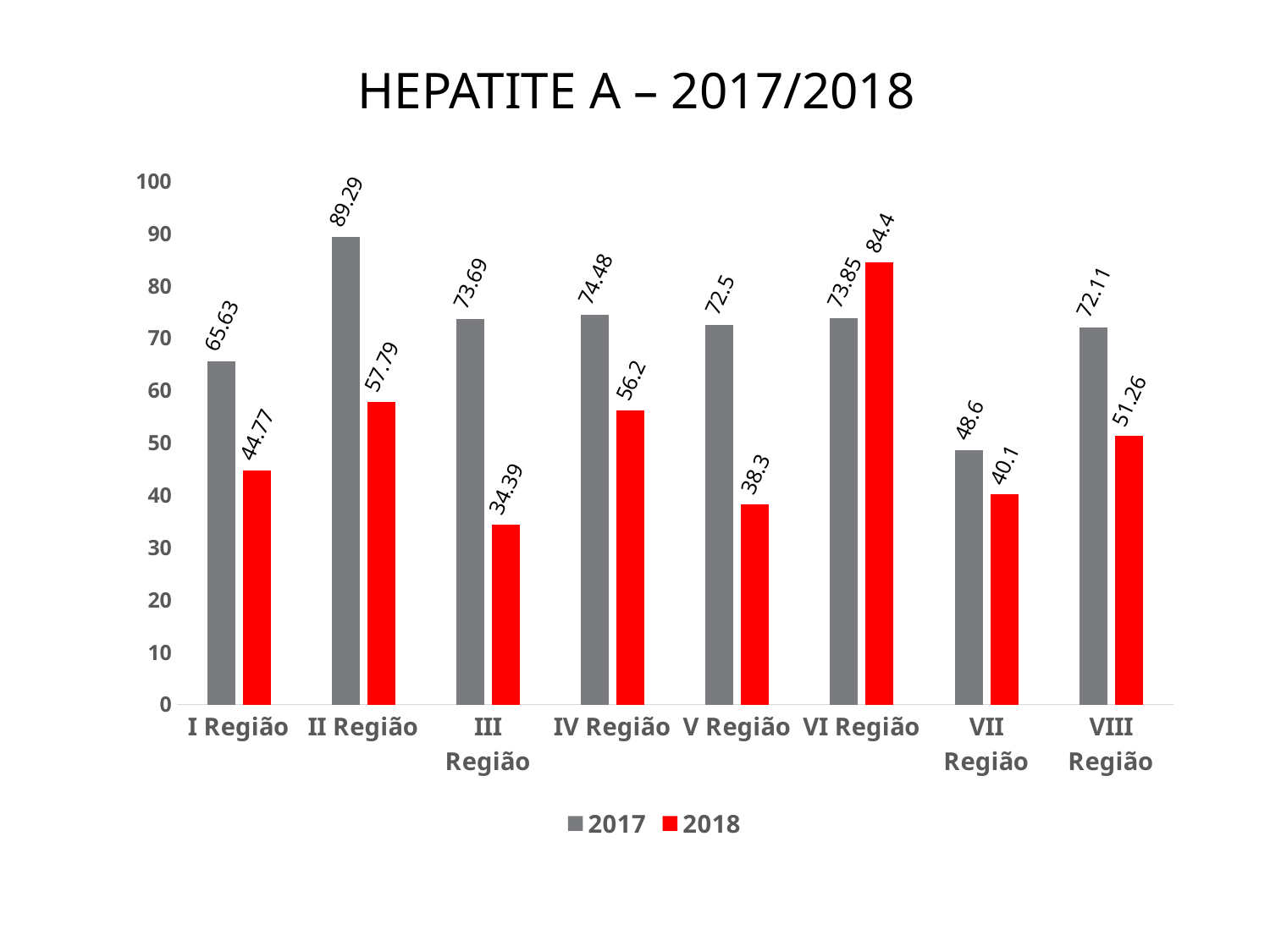
How many series does the legend list? 2 How many regions are shown on the x axis? 8 Which is larger for VI Região, the 2017 value or the 2018 value? 2018 What kind of chart is shown? bar chart What is the difference between the 2017 and 2018 values for I Região? 20.86 Which region has the highest 2017 value? II Região What is the 2018 value for VI Região? 84.4 What is the 2018 value for III Região? 34.39 Which region has the lowest 2018 value? III Região What is the 2017 value for II Região? 89.29 What is the title of the chart? HEPATITE A – 2017/2018 Is the 2018 value for VII Região greater or less than 50? less